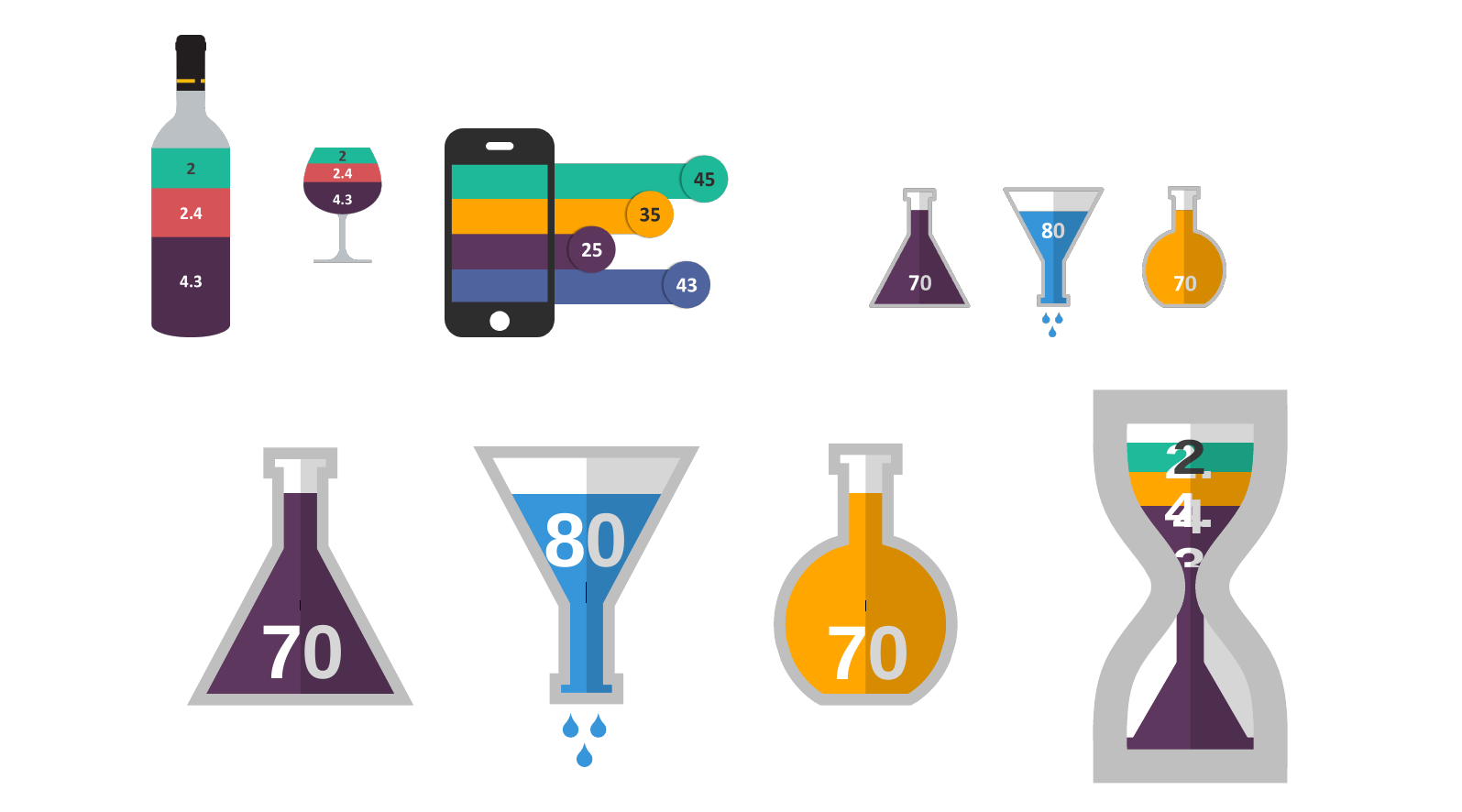
In the phone bar chart, what is the value of the green (top) bar? 45 In the phone bar chart, what is the difference between the highest and lowest bar values? 20 In the wine bottle graphic, what is the total of the three segment values? 8.7 In the phone bar chart, what is the value of the blue (bottom) bar? 43 In the phone bar chart, what is the value of the orange bar? 35 In the phone bar chart, which bar has the highest value? The green bar (45) In the wine bottle graphic, what is the value of the largest (bottom, dark purple) segment? 4.3 What value is shown on the orange round-bottom flask graphic? 70 In the phone bar chart, is the orange bar's value larger or smaller than the blue bar's value? Smaller What value is shown on the blue funnel graphic? 80 How many bars extend from the phone in the phone bar chart? 4 In the phone bar chart, which bar has the lowest value? The purple bar (25)